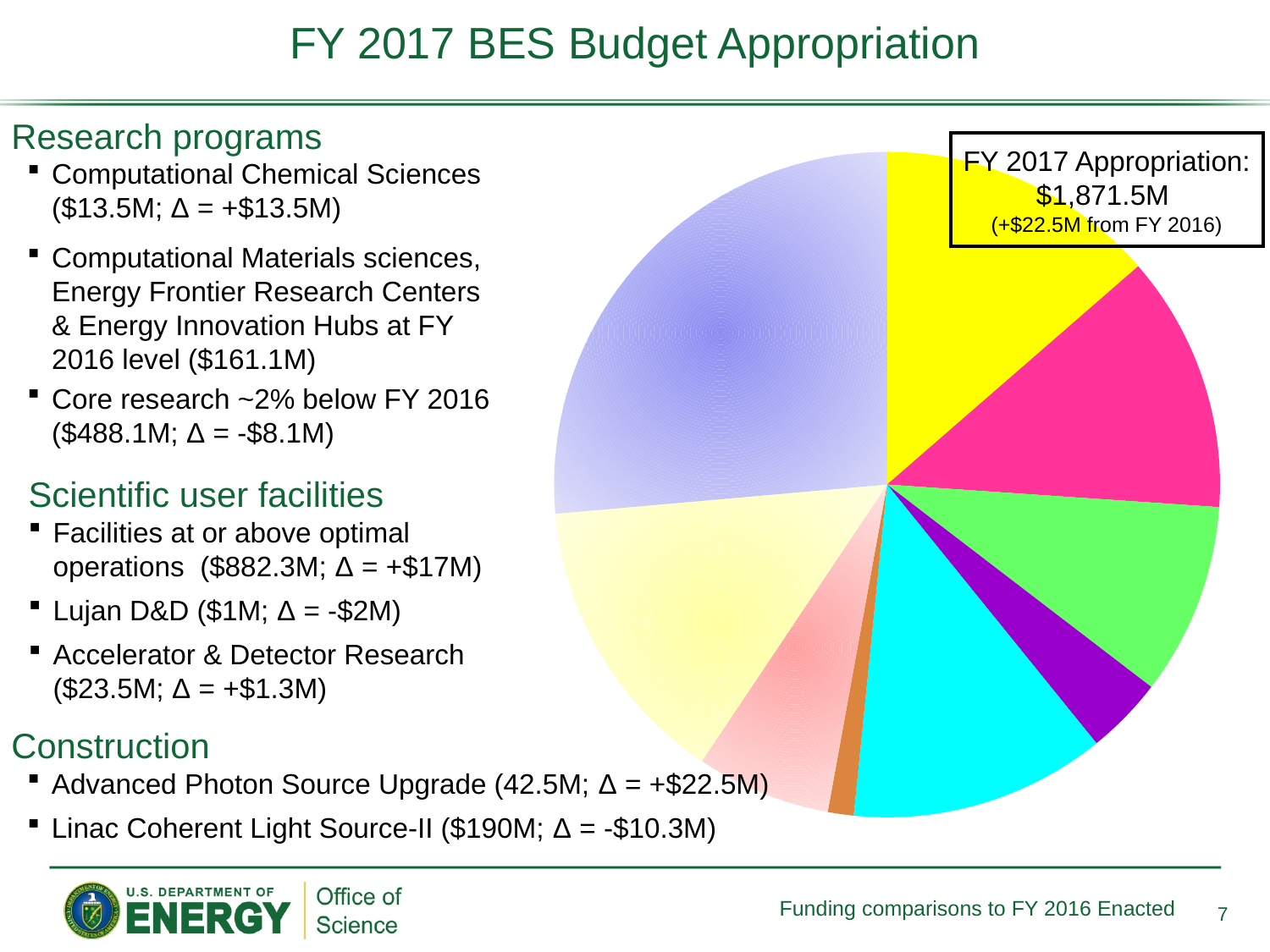
What FY 2017 appropriation total is shown in the box on the chart? $1,871.5M According to the box on the chart, how much did the appropriation change from FY 2016? +$22.5M Which colour slice is the smallest in the pie chart? Orange How many slices does the pie chart have? 9 Which slice is larger, the yellow slice or the purple slice? Yellow What kind of chart is shown on the slide? Pie chart Which slice is larger, the cyan slice or the orange slice? Cyan Which slice is larger, the magenta slice or the green slice? Magenta Which colour slice is the largest in the pie chart? Lavender (light purple)